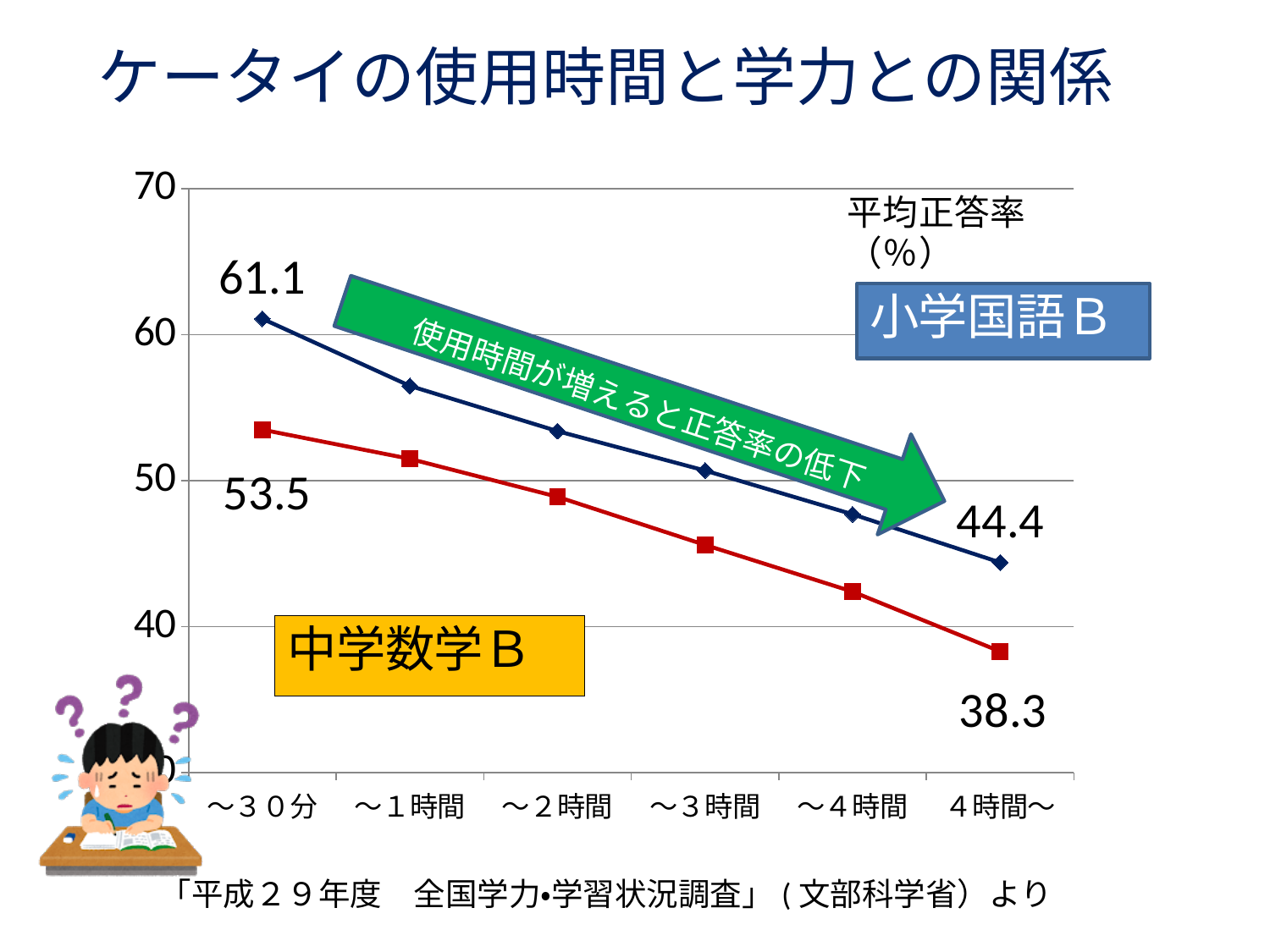
Do the values rise or fall as phone usage time increases along the x axis? fall What is the value for 中学数学B at ４時間～? 38.3 At ４時間～, which series has the higher value, 小学国語B or 中学数学B? 小学国語B What is the value for 小学国語B at ～３０分? 61.1 Is the value for 中学数学B at ～３時間 greater or less than 50? less What kind of chart is shown on the slide? line chart What is the value for 小学国語B at ４時間～? 44.4 What is the difference between the 中学数学B values at ～３０分 and ４時間～? 15.2 How many usage-time categories are shown on the x axis? 6 What is the difference between the 小学国語B values at ～３０分 and ４時間～? 16.7 What is the value for 中学数学B at ～３０分? 53.5 How many data series are plotted on the chart? 2